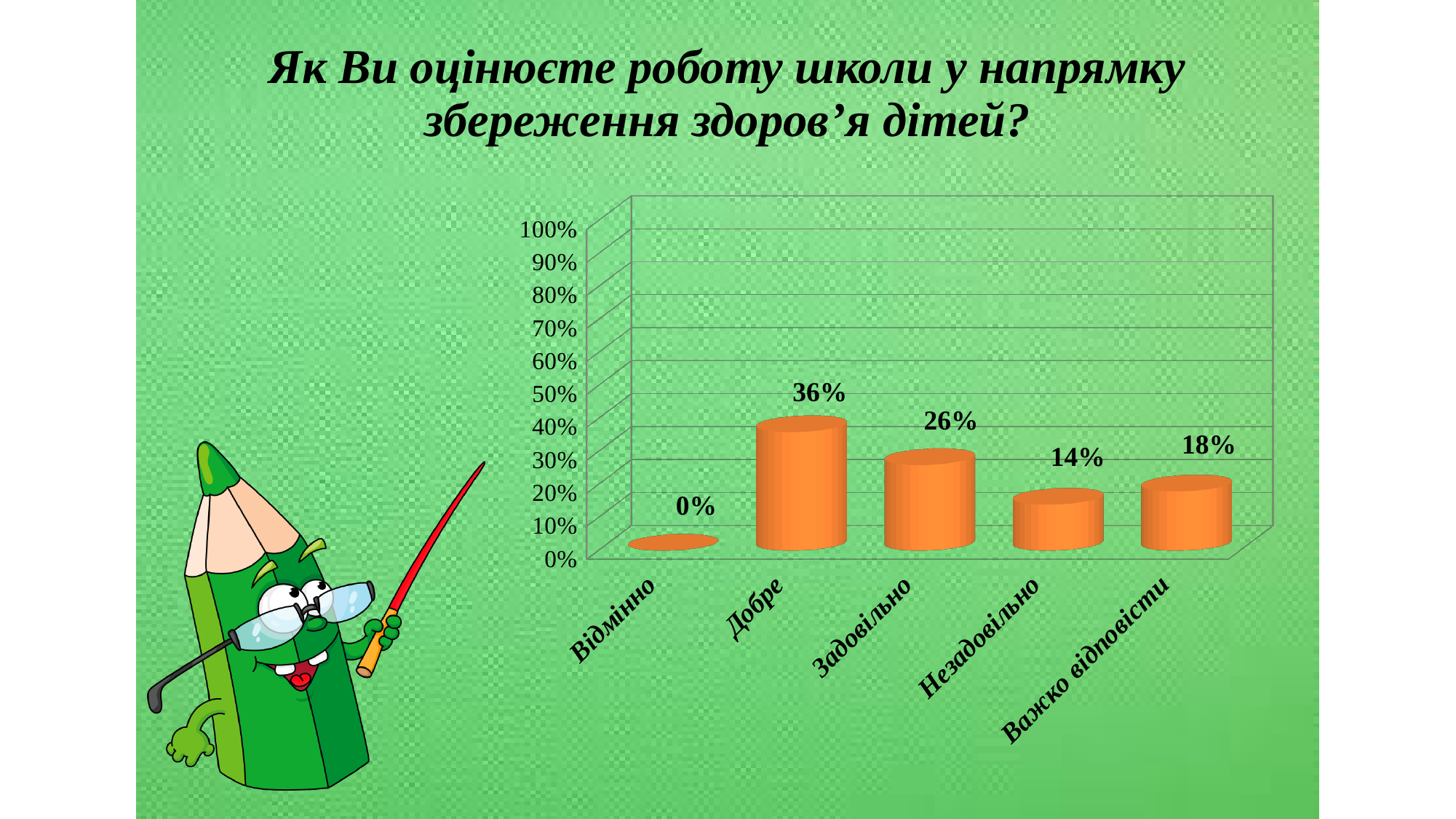
What is the value for Незадовільно? 14% What is the value for Важко відповісти? 18% What is the value for Відмінно? 0% How many categories are shown on the x axis? 5 Which is larger, the value for Незадовільно or the value for Важко відповісти? Важко відповісти Which category has the lowest value? Відмінно What kind of chart is shown on the slide? Bar chart What is the difference between the values for Добре and Задовільно? 10% What is the value for Добре? 36% Which category has the highest value? Добре What is the highest value shown on the vertical axis? 100% What is the value for Задовільно? 26%